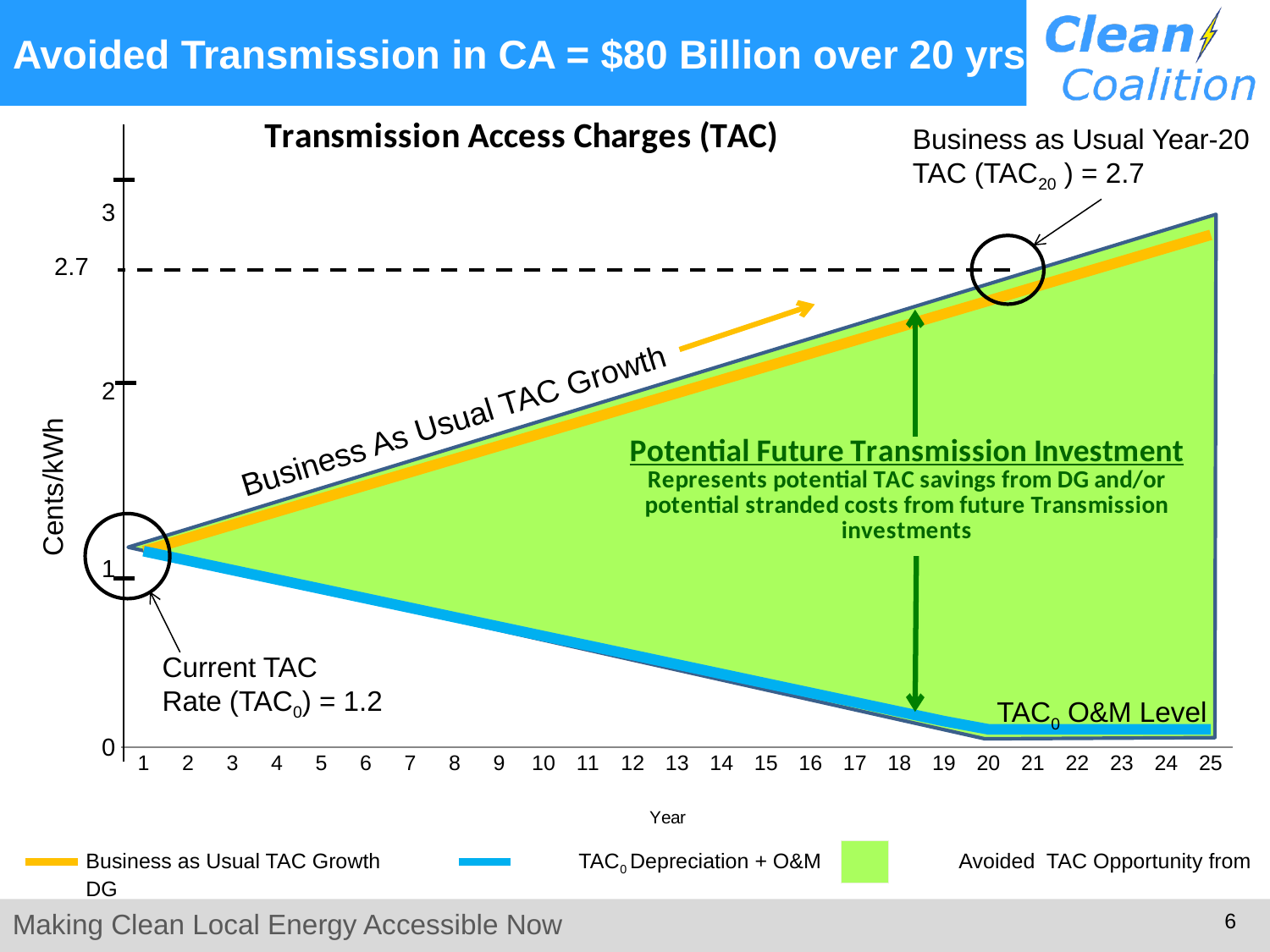
How many entries does the chart legend list? 3 How many years are shown on the x axis of the chart? 25 What unit is shown on the y axis of the chart? Cents/kWh Does the TAC0 Depreciation + O&M line rise or fall as the year increases? falls Does the Business as Usual TAC Growth line rise or fall as the year increases? rises What is the title of the chart? Transmission Access Charges (TAC) What is the Current TAC Rate (TAC0) shown on the chart? 1.2 Is the Business as Usual TAC Growth value at year 5 greater or less than 2? less Is the TAC0 Depreciation + O&M value at year 20 greater or less than 1? less What is the Business as Usual Year-20 TAC (TAC20) shown on the chart? 2.7 By how much does the Business as Usual Year-20 TAC (2.7) exceed the Current TAC Rate (1.2)? 1.5 At year 15, which is larger: Business as Usual TAC Growth or TAC0 Depreciation + O&M? Business as Usual TAC Growth